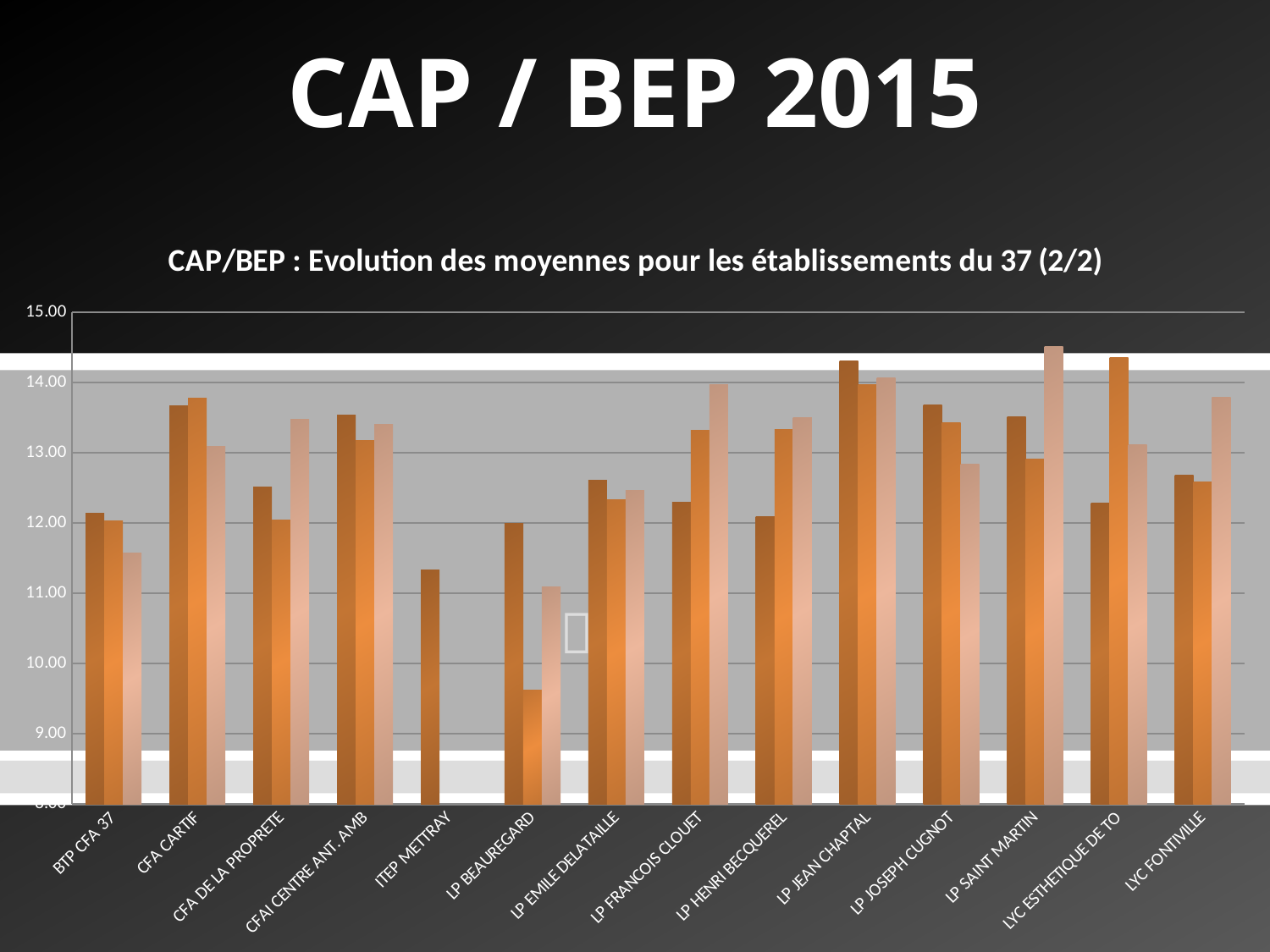
What kind of chart is shown on the slide? bar chart Which establishment has the lowest bar in the chart? LP BEAUREGARD Is the value of the first bar for LP JEAN CHAPTAL greater or less than 14.00? greater Which is larger: the first bar for CFA CARTIF or the first bar for ITEP METTRAY? CFA CARTIF Is the value of the first bar for CFA CARTIF greater or less than 13.00? greater Is the value of the first bar for ITEP METTRAY greater or less than 12.00? less How many bars are plotted for each establishment such as CFA CARTIF? 3 How many establishments (categories) are shown on the x axis of the chart? 14 What is the title of the chart? CAP/BEP : Evolution des moyennes pour les établissements du 37 (2/2)